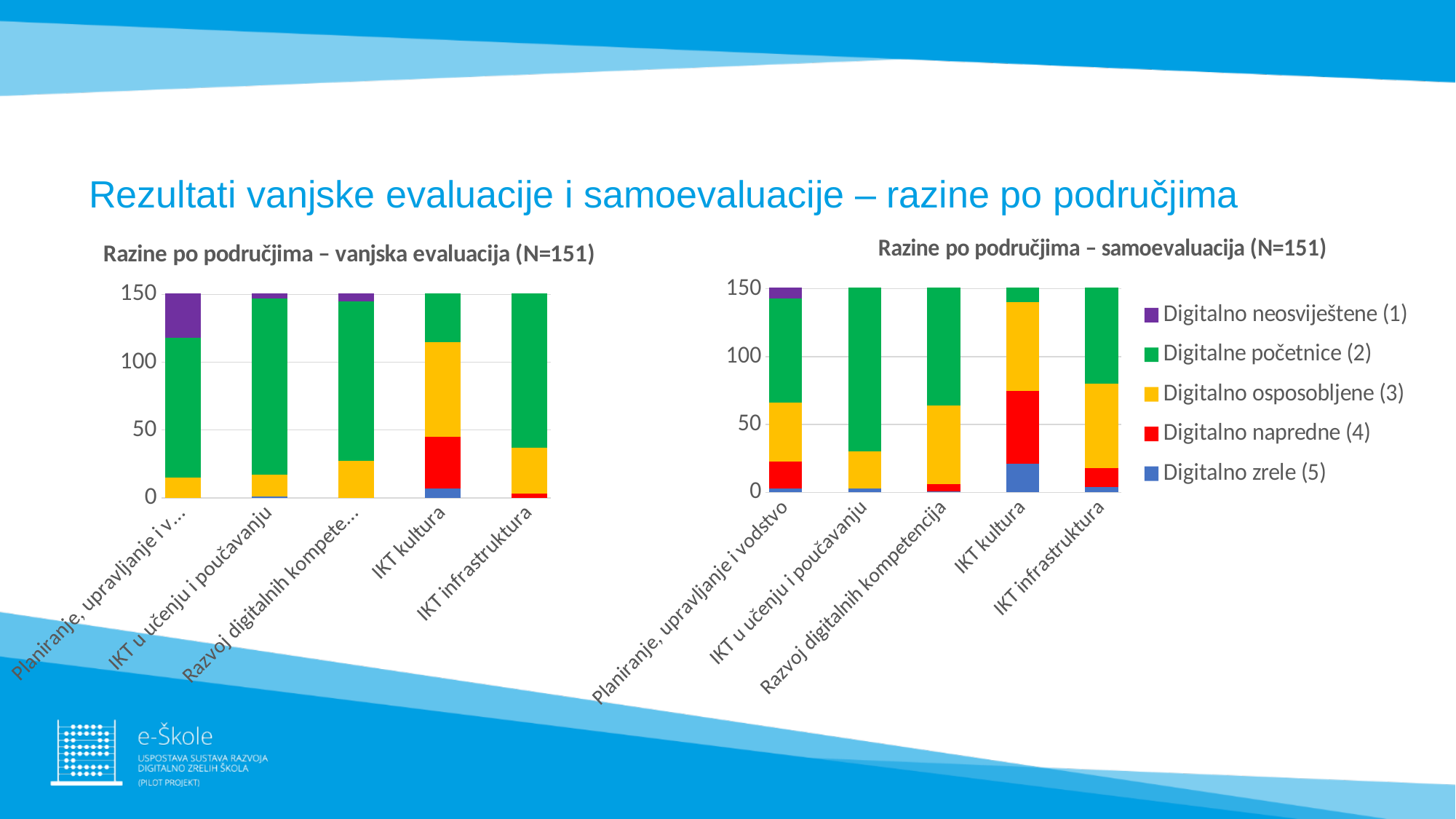
What is the title of the right chart on the slide? Razine po područjima – samoevaluacija (N=151) What type of chart is the left chart titled "Razine po područjima – vanjska evaluacija (N=151)"? Stacked bar chart In the right chart (samoevaluacija), is the "Digitalne početnice (2)" value for IKT kultura greater or less than 50? less Which legend entry is shown in purple on the slide? Digitalno neosviještene (1) In the left chart (vanjska evaluacija), is the "Digitalne početnice (2)" value for IKT u učenju i poučavanju greater or less than 100? greater In the right chart (samoevaluacija), which category has the largest "Digitalno napredne (4)" segment? IKT kultura In the left chart (vanjska evaluacija), is the "Digitalno osposobljene (3)" value for IKT kultura greater or less than 50? greater In the right chart (samoevaluacija), is the "Digitalno osposobljene (3)" segment larger for IKT infrastruktura or for IKT u učenju i poučavanju? IKT infrastruktura How many categories are shown on the x axis of the right chart titled "Razine po područjima – samoevaluacija (N=151)"? 5 How many series does the legend list for the charts on the slide? 5 In the right chart (samoevaluacija), which category has the largest "Digitalne početnice (2)" segment? IKT u učenju i poučavanju In the right chart (samoevaluacija), which category has the largest "Digitalno zrele (5)" segment? IKT kultura